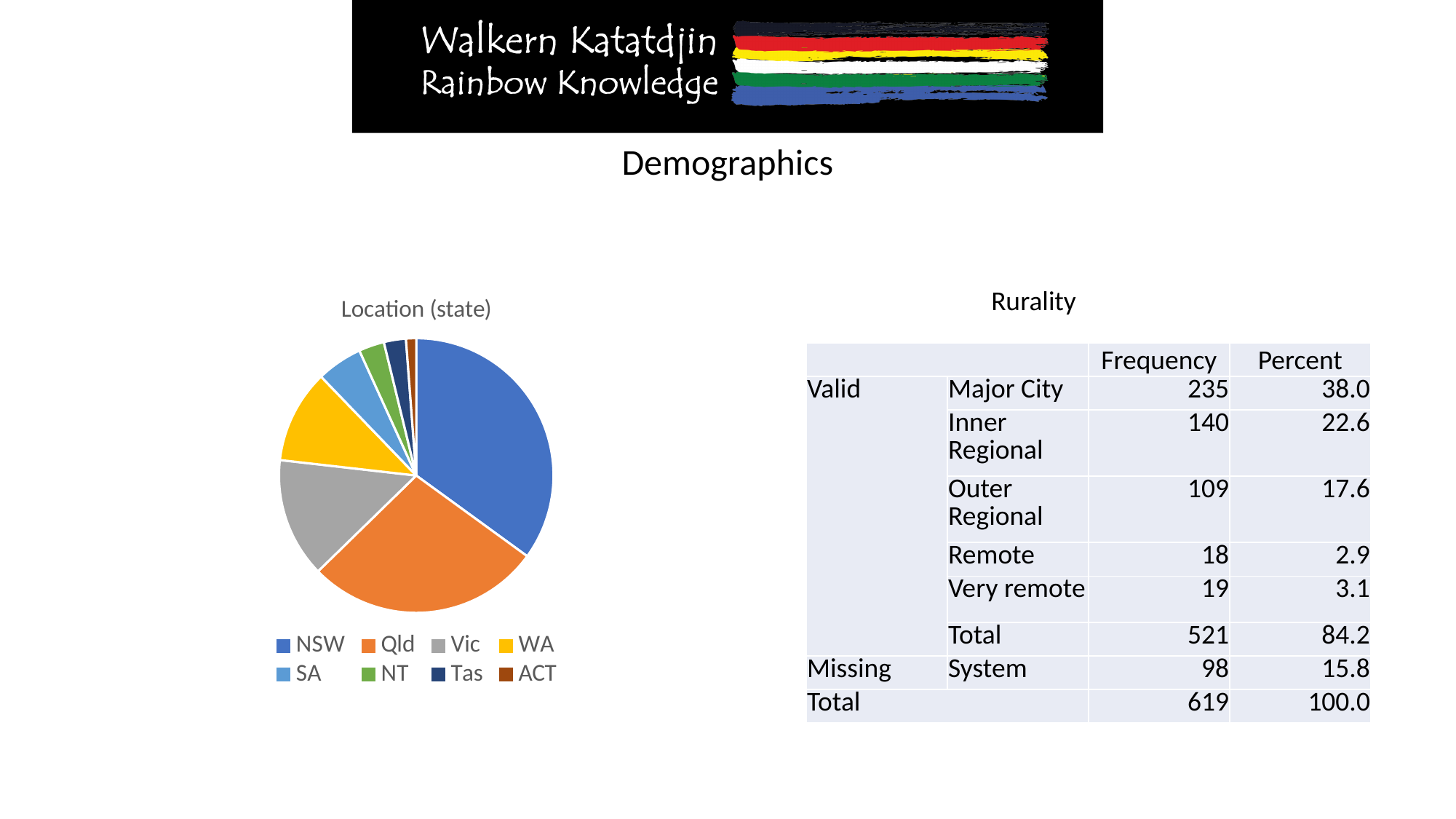
How many entries does the legend of the "Location (state)" chart list? 8 In the "Location (state)" pie chart, which slice is larger, NSW or Qld? NSW How many slices does the "Location (state)" pie chart have? 8 In the "Location (state)" pie chart, which slice is larger, SA or NT? SA Which category has the smallest slice in the "Location (state)" pie chart? ACT What colour is the WA slice in the "Location (state)" pie chart? yellow Which state has the largest slice in the "Location (state)" pie chart? NSW In the "Location (state)" pie chart, which slice is larger, Vic or SA? Vic What is the title of the pie chart on the slide? Location (state) What kind of chart is the "Location (state)" chart? pie chart